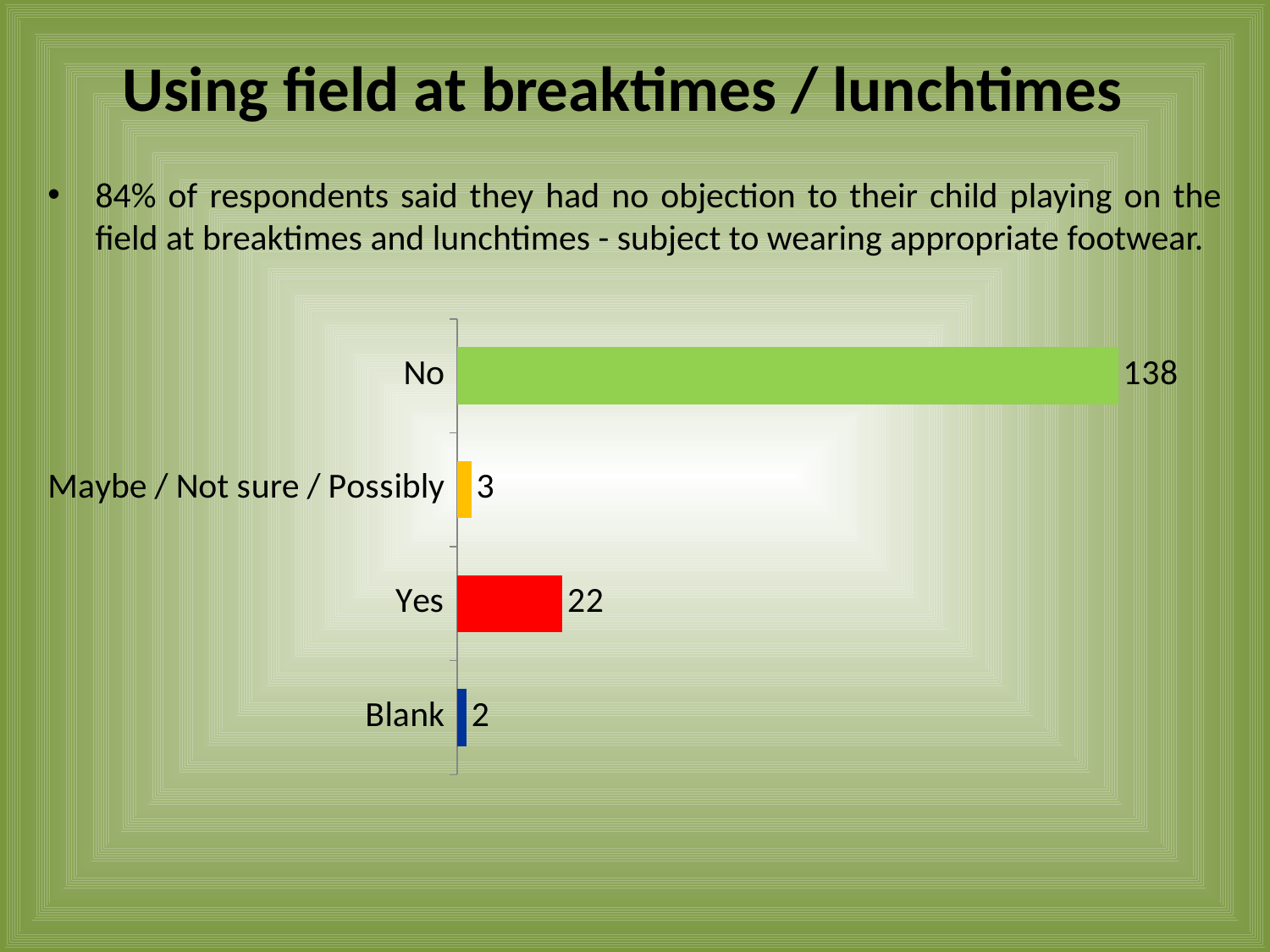
What is the difference between the values for Maybe / Not sure / Possibly and Blank? 1 How many categories are shown in the chart? 4 What kind of chart is shown on the slide? Bar chart Which category has the lowest value? Blank What is the value for Maybe / Not sure / Possibly? 3 What is the difference between the values for No and Yes? 116 What colour is the bar for Yes? Red Which is larger, the value for Yes or the value for Maybe / Not sure / Possibly? Yes What is the value for Blank? 2 Which category has the highest value? No What is the value for No? 138 What is the value for Yes? 22